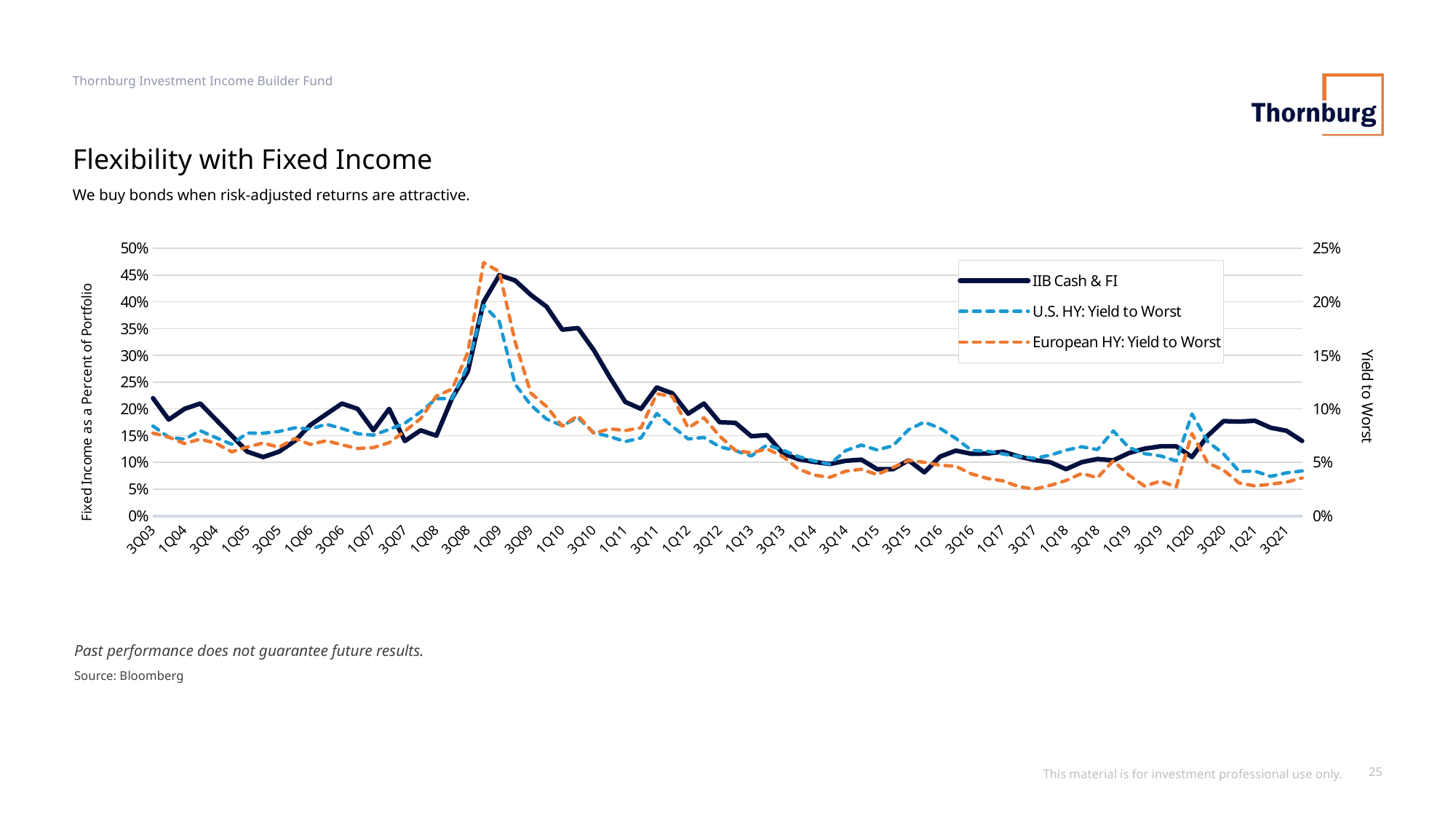
Is the value of IIB Cash & FI at 3Q05 greater or less than 15%? less How many series does the chart legend list? 3 Is the value of IIB Cash & FI at 3Q21 greater or less than 20%? less What kind of chart is shown on the slide? Line chart What are the three series listed in the chart legend? IIB Cash & FI, U.S. HY: Yield to Worst, European HY: Yield to Worst Does the IIB Cash & FI line rise or fall between 1Q09 and 1Q11? Fall What is the title of the left vertical axis of the chart? Fixed Income as a Percent of Portfolio Is the European HY: Yield to Worst value at 1Q09 greater or less than 20%? greater At 1Q09, which is higher: U.S. HY: Yield to Worst or European HY: Yield to Worst? European HY: Yield to Worst In which quarter does the IIB Cash & FI line reach its highest value? 1Q09 Does the IIB Cash & FI line rise or fall between 3Q07 and 1Q09? Rise